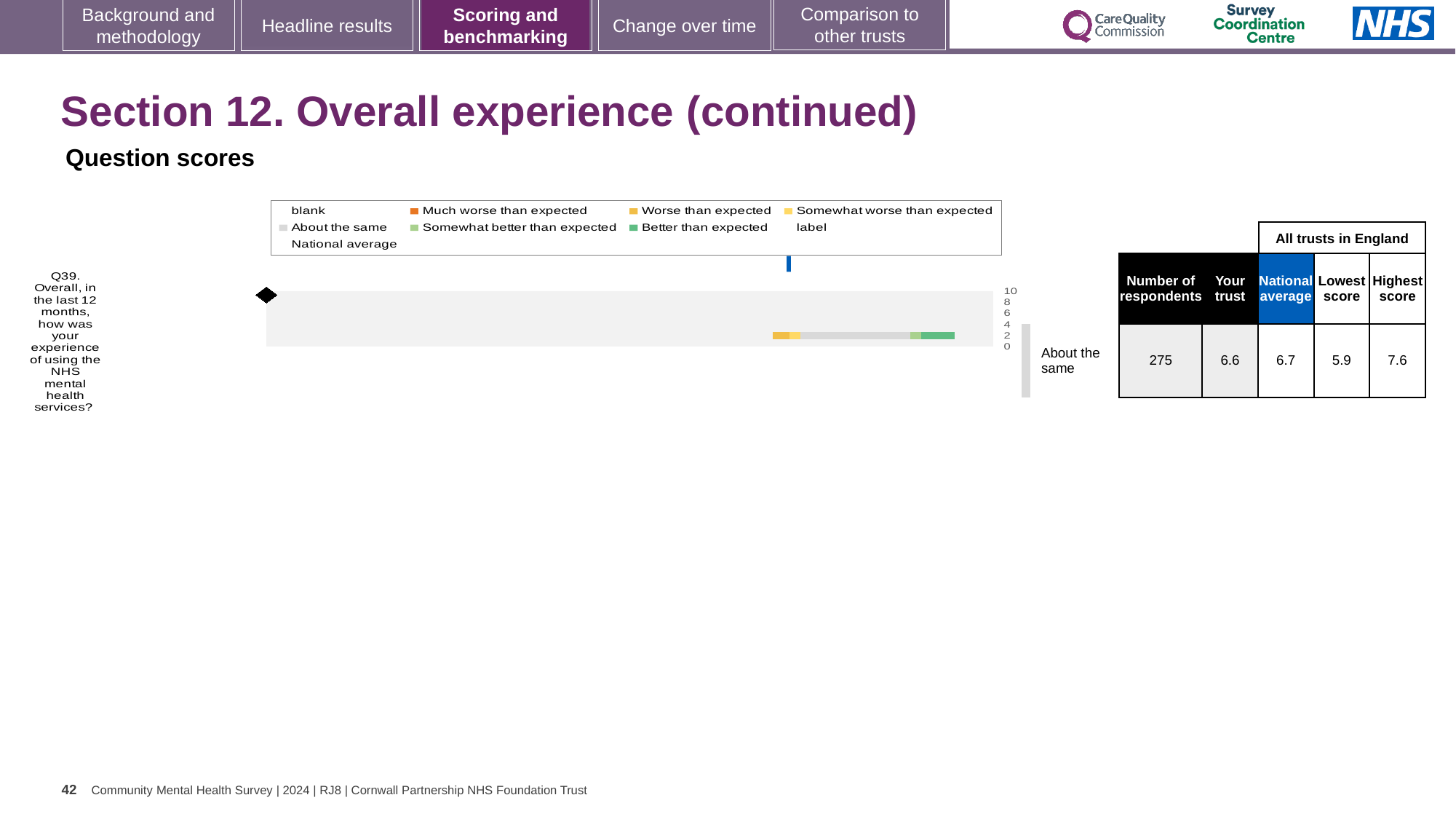
How many question categories are plotted in the chart? 1 Which question is plotted in the chart? Q39. Overall, in the last 12 months, how was your experience of using the NHS mental health services? According to the table next to the chart, what is the 'Your trust' score for Q39? 6.6 What is the difference between the highest score and the lowest score for Q39 in the table next to the chart? 1.7 According to the table next to the chart, what is the highest score among all trusts in England for Q39? 7.6 How many entries does the chart legend list? 9 According to the table next to the chart, what is the lowest score among all trusts in England for Q39? 5.9 According to the table next to the chart, how many respondents answered Q39? 275 What is the highest value shown on the chart's axis? 10 What kind of chart is shown on the slide? bar chart Which is larger for Q39, the 'Your trust' score or the national average? National average According to the table next to the chart, what is the national average score for Q39? 6.7